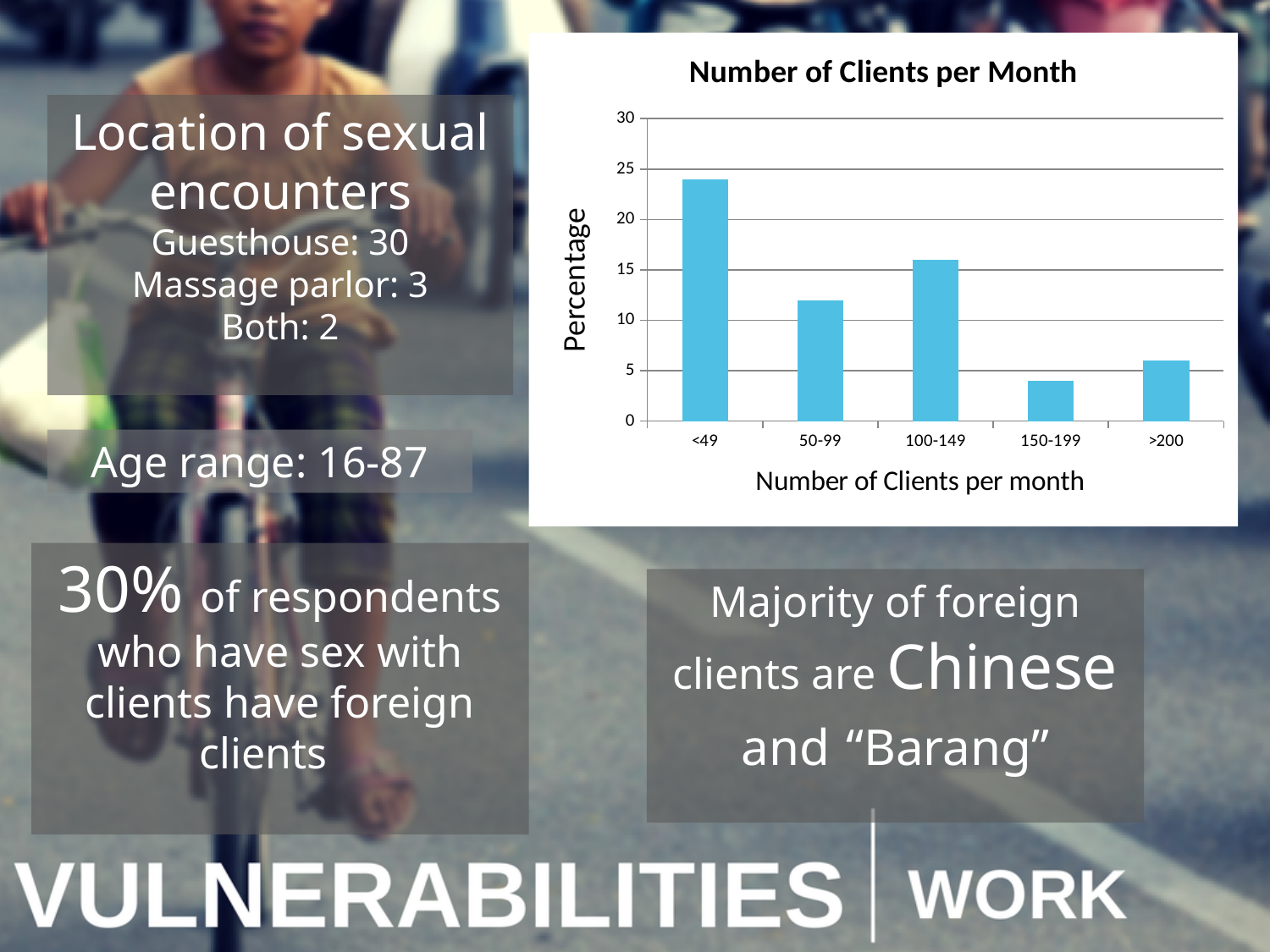
Is the value for 150-199 greater or less than 5? less Which has a higher percentage, 50-99 or 100-149? 100-149 Which category has the highest percentage in the Number of Clients per Month chart? <49 What type of chart is shown on the slide? bar chart Is the value for <49 greater or less than 20? greater Is the value for 50-99 greater or less than 10? greater What is the title of the chart? Number of Clients per Month What is the label on the y axis of the chart? Percentage How many categories are shown on the x axis of the Number of Clients per Month chart? 5 Which has a higher percentage, 150-199 or >200? >200 Which category has the lowest percentage in the Number of Clients per Month chart? 150-199